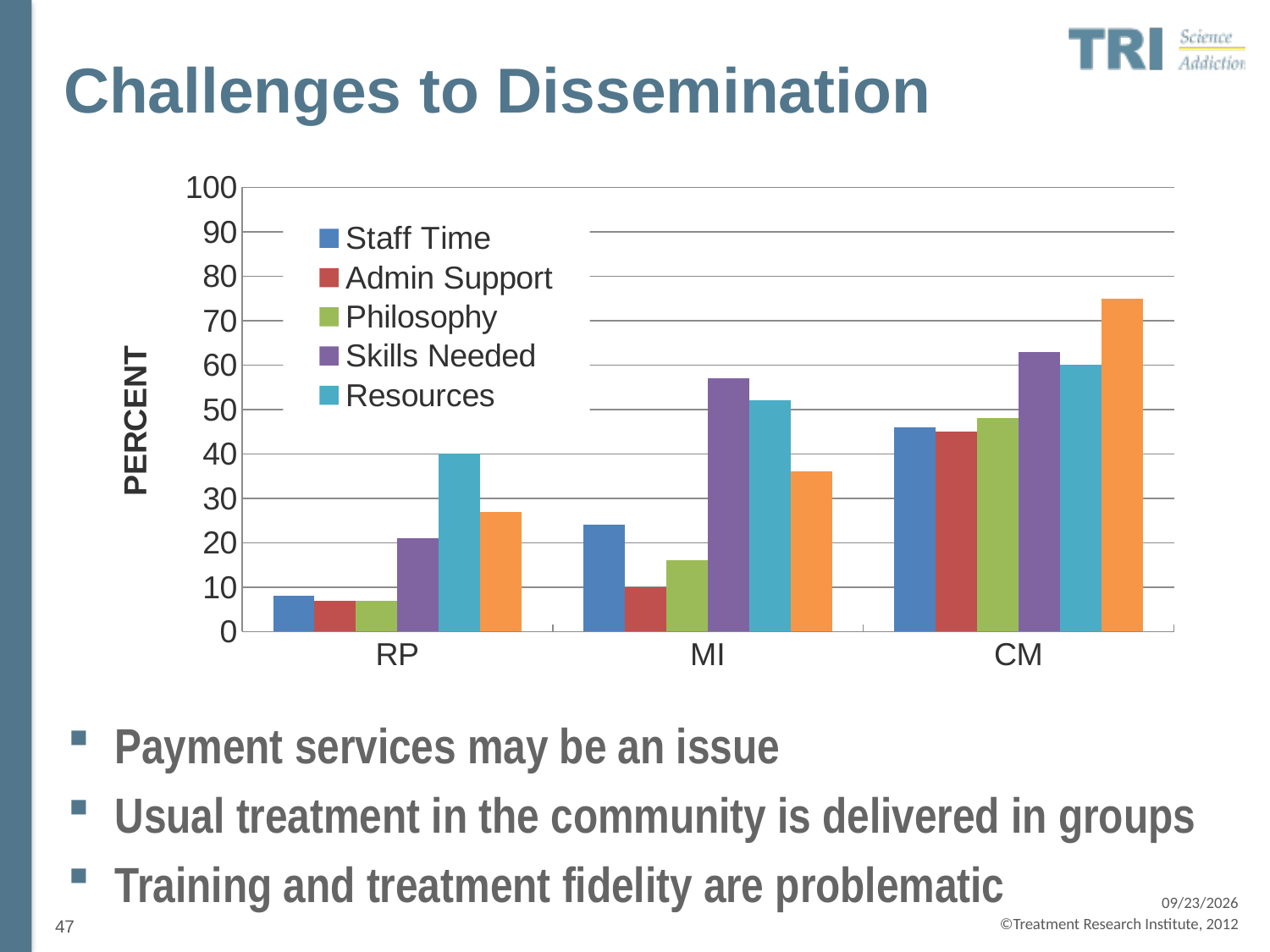
How many categories are shown on the x axis of the chart? 3 Is the value for Philosophy in the CM category greater or less than 40? greater Is the value for Staff Time in the MI category greater or less than 20? greater Is the value for Skills Needed in the MI category greater or less than 50? greater Which category has the highest value for Staff Time? CM What kind of chart is shown on the slide? bar chart What is the title of the slide containing the chart? Challenges to Dissemination Do the Staff Time values rise or fall moving from RP to MI to CM? rise What is the title of the chart's vertical axis? PERCENT How many series does the chart's legend list? 5 Which category has the lowest value for Skills Needed? RP